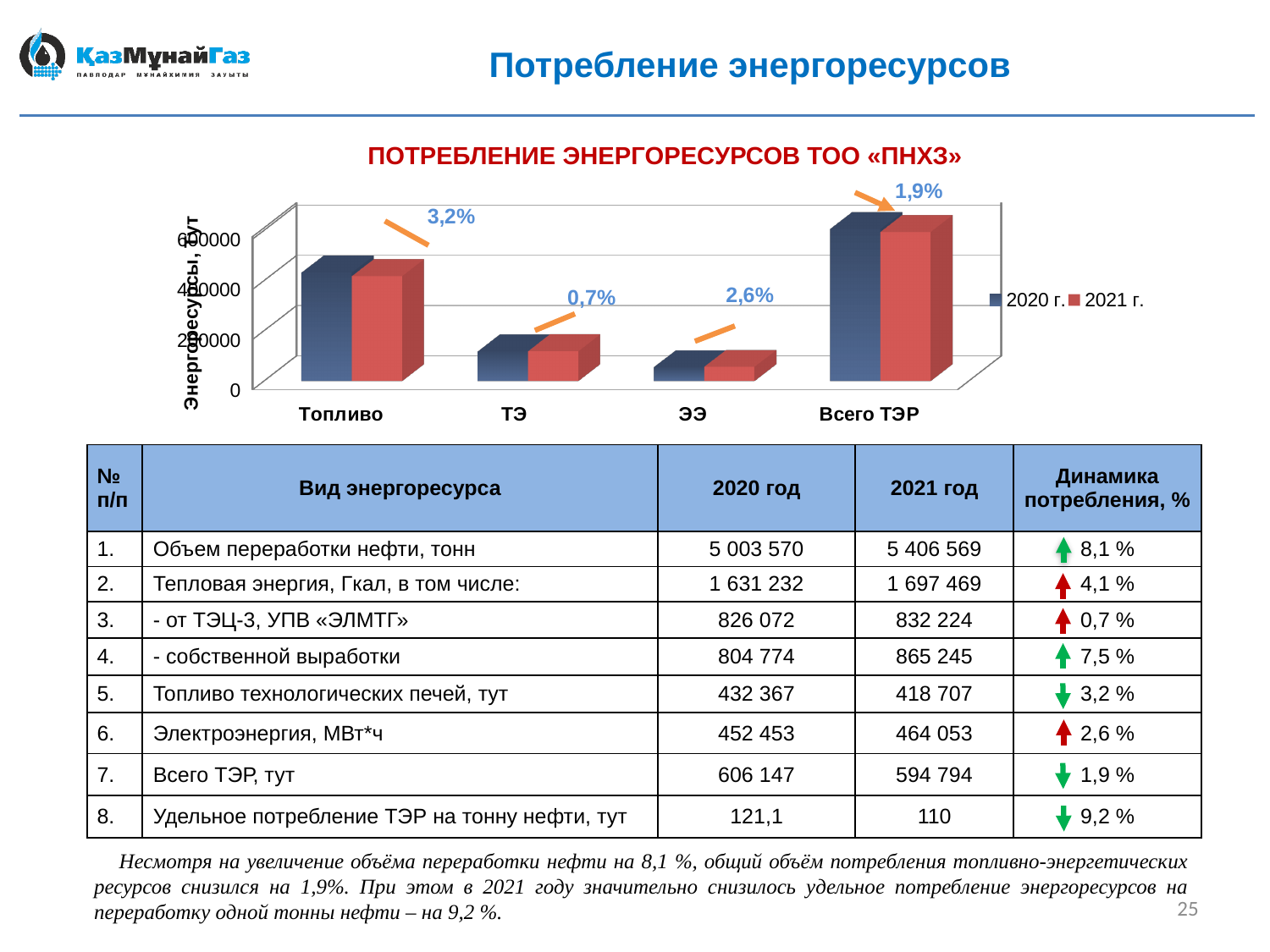
What percentage label is shown above the Всего ТЭР bars in the chart? 1,9% Is the 2021 г. value for ТЭ in the chart greater or less than 200000? less What kind of chart is shown on the slide? bar chart Which is larger in the chart: the 2020 г. bar for Топливо or the 2020 г. bar for ТЭ? Топливо Which category has the tallest bars in the chart? Всего ТЭР How many series does the chart legend list? 2 What are the two series named in the chart legend? 2020 г. and 2021 г. How many categories are shown on the x axis of the chart? 4 Which category has the shortest bars in the chart? ЭЭ What percentage label is shown above the Топливо bars in the chart? 3,2% What is the title of the chart? ПОТРЕБЛЕНИЕ ЭНЕРГОРЕСУРСОВ ТОО «ПНХЗ» Is the 2020 г. value for Всего ТЭР in the chart greater or less than 400000? greater